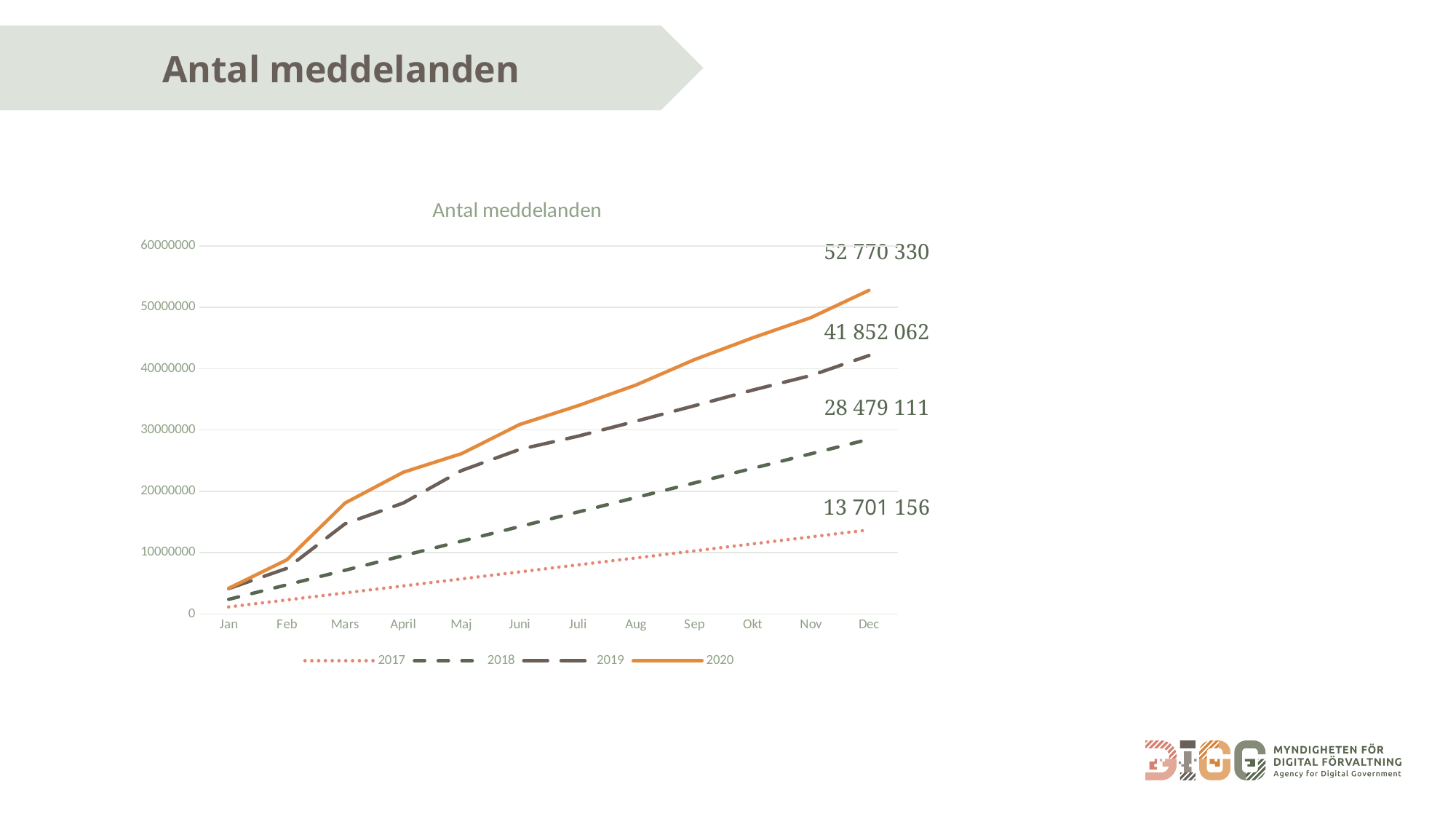
Which series has the lowest value in Dec? 2017 What is the difference between the Dec values for 2020 and 2019? 10 918 268 Is the value for 2020 in Juli greater or less than 30000000? greater What kind of chart is shown on the slide? Line chart What is the value for 2018 in Dec? 28 479 111 What is the value for 2017 in Dec? 13 701 156 What is the value for 2020 in Dec? 52 770 330 Is the value for 2019 in Mars greater or less than 20000000? less How many series does the legend list? 4 What is the value for 2019 in Dec? 41 852 062 How many months are shown on the x axis? 12 Which series has the highest value in Dec? 2020